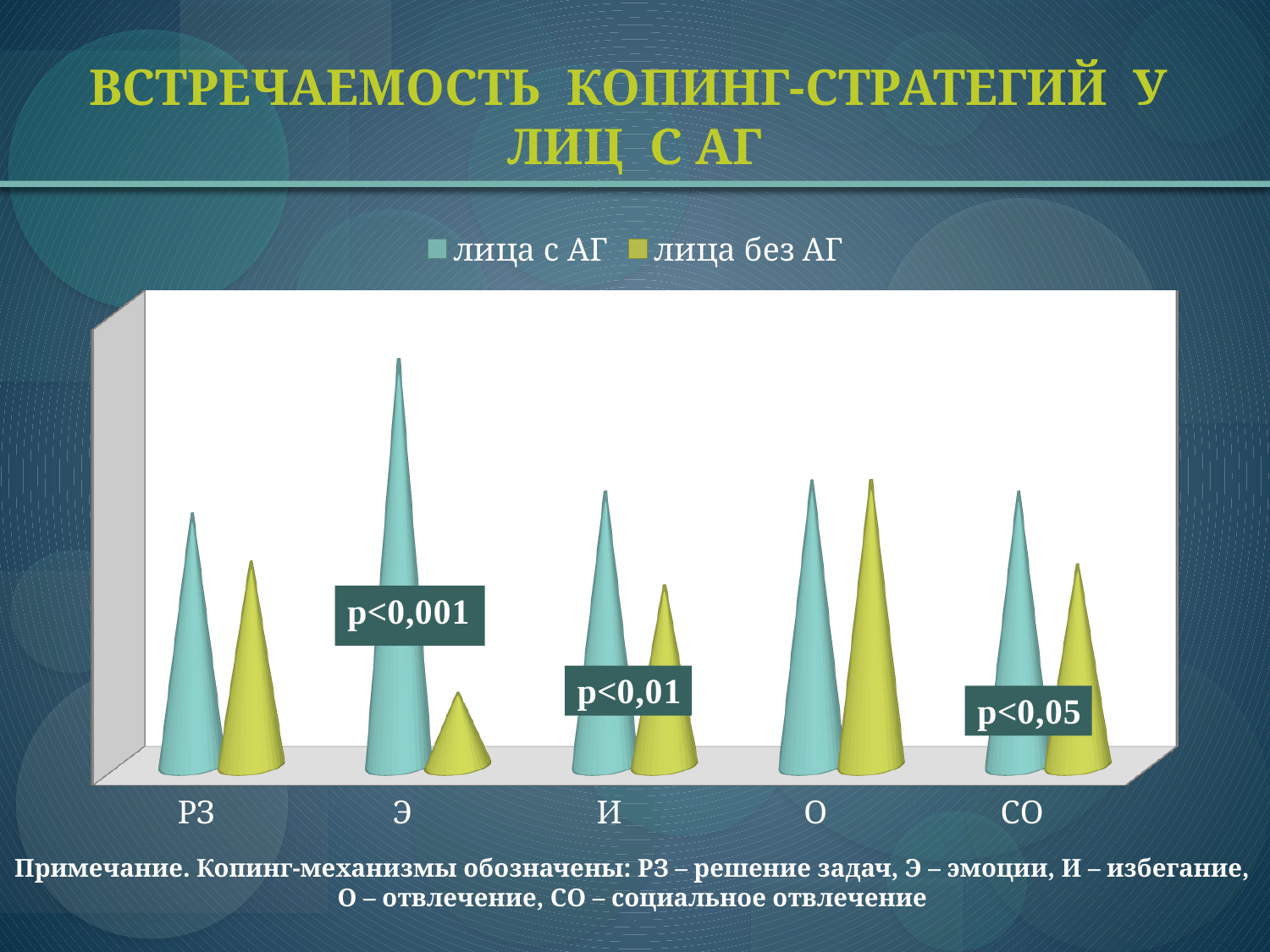
What are the two series names listed in the chart's legend? лица с АГ, лица без АГ How many series does the chart's legend list? 2 How many categories are shown along the x axis of the chart? 5 For the series 'лица без АГ', which category has the lowest value? Э For the series 'лица с АГ', which category has the highest value? Э For the series 'лица без АГ', which category has the highest value? О What significance level is annotated above category Э in the chart? p<0,001 In category Э, which series has the larger value: 'лица с АГ' or 'лица без АГ'? лица с АГ In category И, which series has the larger value: 'лица с АГ' or 'лица без АГ'? лица с АГ In category РЗ, which series has the larger value: 'лица с АГ' or 'лица без АГ'? лица с АГ What kind of chart is shown on the slide? bar chart